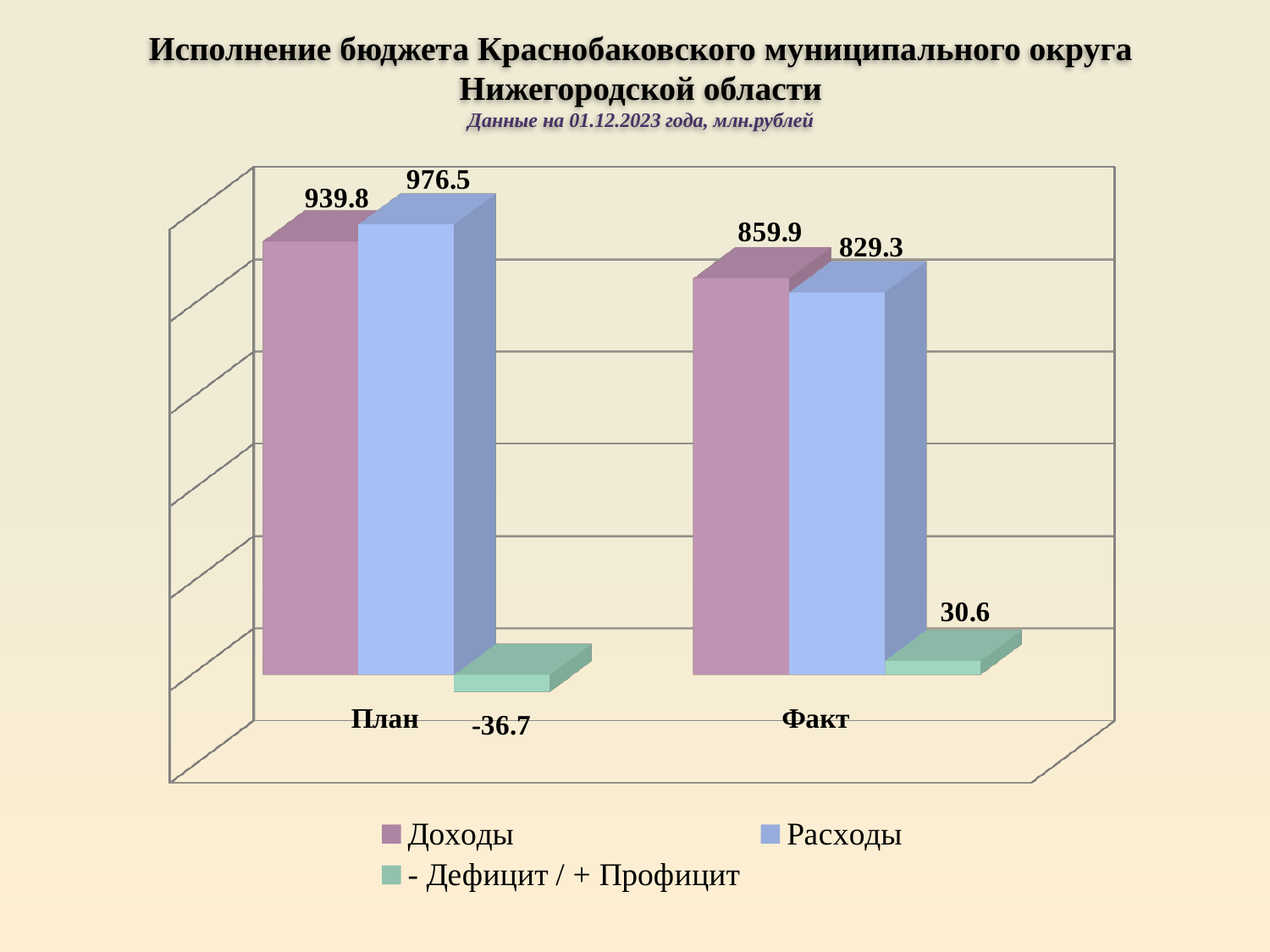
Which category has the higher Расходы value, План or Факт? План How many categories are shown on the x axis? 2 What is the difference between Доходы for План and Доходы for Факт? 79.9 What is the difference between Расходы and Доходы for План? 36.7 What unit of measurement is stated in the chart subtitle? млн.рублей What type of chart is shown on the slide? Bar chart What is the value of Расходы for Факт? 829.3 How many series does the legend list? 3 For Факт, which is larger, Доходы or Расходы? Доходы What is the value of '- Дефицит / + Профицит' for План? -36.7 What is the value of Доходы for План? 939.8 What is the value of '- Дефицит / + Профицит' for Факт? 30.6